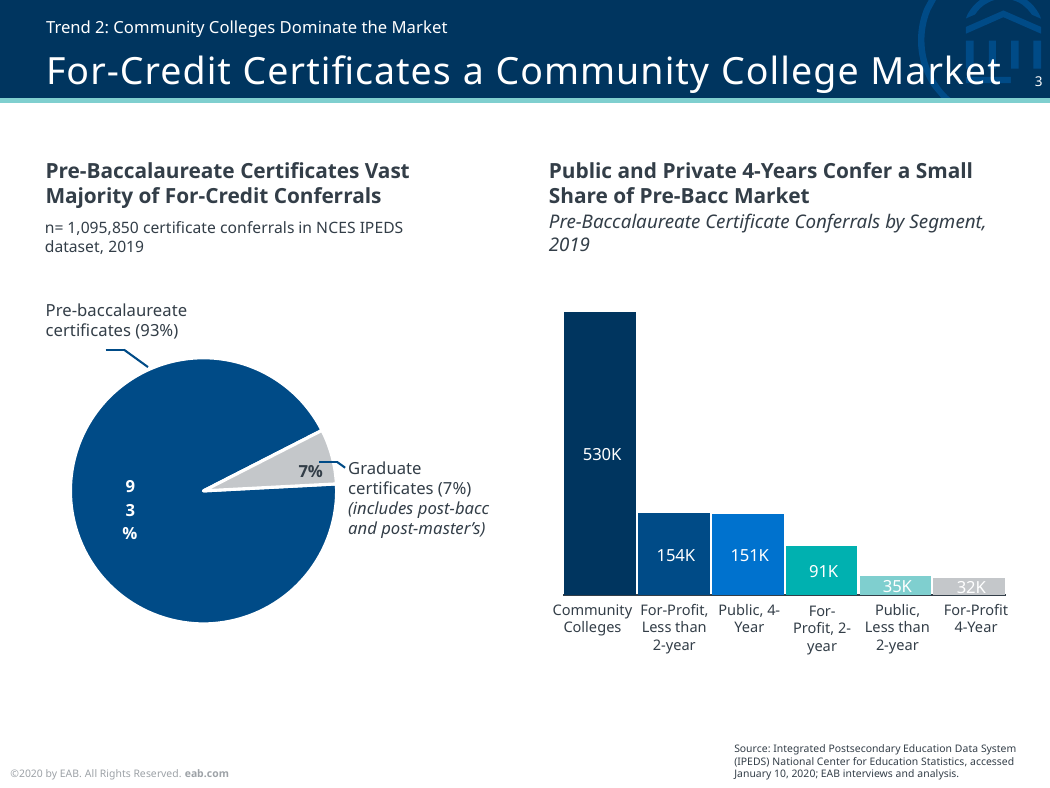
In the bar chart on the right, what is the value for Public, 4-Year? 151K In the bar chart on the right, how many pre-baccalaureate certificate conferrals did Community Colleges have in 2019? 530K In the bar chart on the right, what is the difference between Community Colleges and For-Profit, Less than 2-year? 376K In the pie chart on the left, what share of for-credit conferrals are graduate certificates? 7% In the bar chart on the right, which segment has the highest number of conferrals? Community Colleges In the bar chart on the right, which is larger: Public, 4-Year or For-Profit, 2-year? Public, 4-Year In the bar chart on the right, what is the value for For-Profit, 2-year? 91K In the bar chart on the right, which segment has the lowest number of conferrals? For-Profit 4-Year What type of chart is the chart on the left of the slide? Pie chart In the bar chart on the right, what is the difference between For-Profit, 2-year and Public, Less than 2-year? 56K In the pie chart on the left, what share of for-credit conferrals are pre-baccalaureate certificates? 93% How many segments are shown in the bar chart on the right? 6